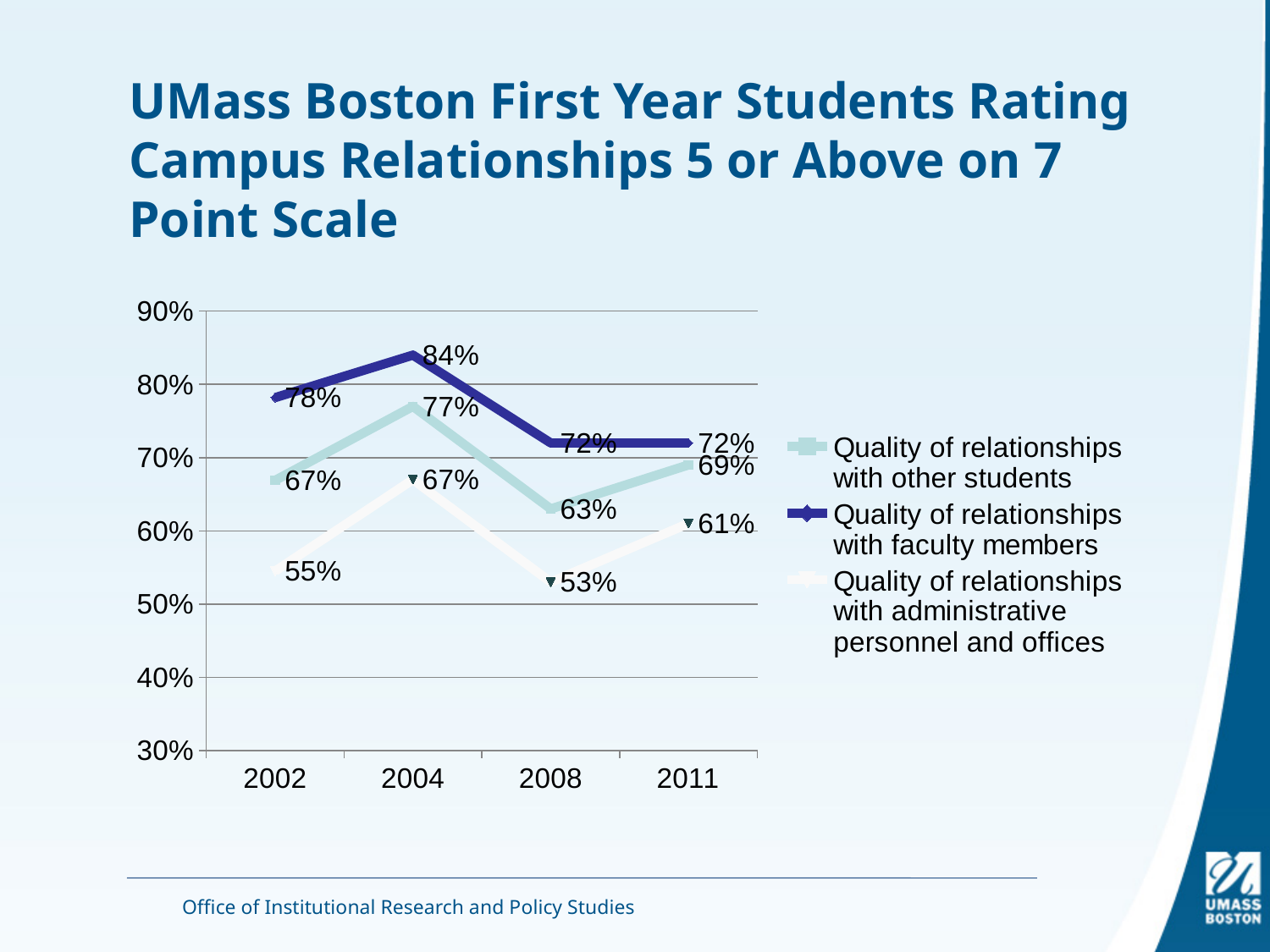
What is the value for quality of relationships with other students in 2011? 69% How many series does the legend list? 3 What is the difference between the 2004 and 2008 values for quality of relationships with other students? 14 percentage points How many years are shown on the x axis? 4 Which series had the higher value in 2002: quality of relationships with other students or quality of relationships with administrative personnel and offices? Quality of relationships with other students Did the rating for quality of relationships with faculty members rise or fall from 2004 to 2008? fall In which year was the rating for quality of relationships with administrative personnel and offices lowest? 2008 Which series is drawn with the dark blue line? Quality of relationships with faculty members What percentage of first year students rated the quality of relationships with faculty members 5 or above in 2004? 84% In which year was the rating for quality of relationships with faculty members highest? 2004 What kind of chart is shown on the slide? line chart What is the value for quality of relationships with administrative personnel and offices in 2008? 53%